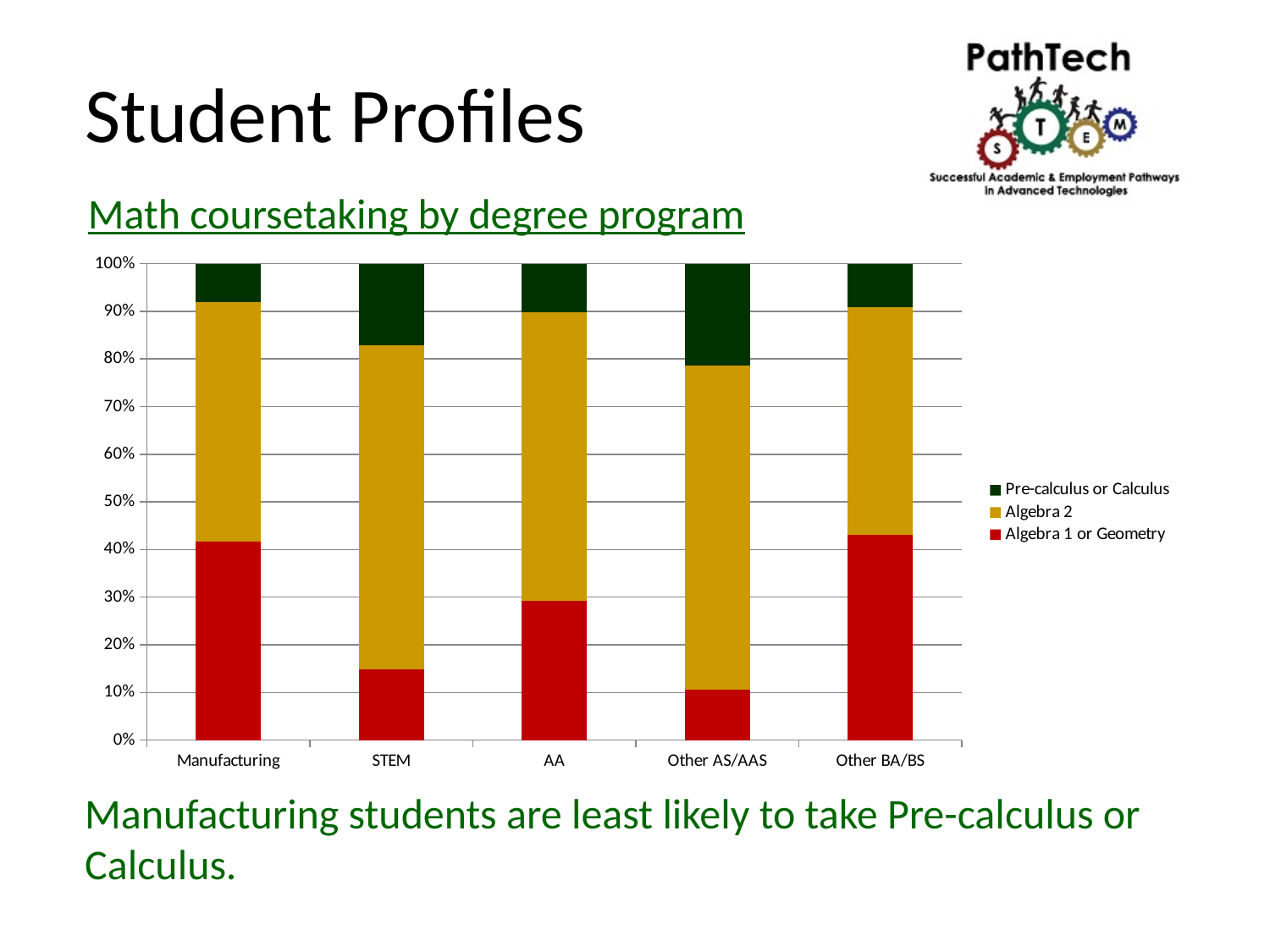
Is the Algebra 1 or Geometry share for STEM greater or less than 20%? less What is the title of the chart? Math coursetaking by degree program How many series does the legend list? 3 Is the Algebra 1 or Geometry share for Manufacturing greater or less than 40%? greater Which degree program has the smallest Algebra 1 or Geometry share? Other AS/AAS How many degree programs are shown along the x axis? 5 Which has the larger Algebra 1 or Geometry share, STEM or AA? AA What kind of chart is shown on the slide? Stacked bar chart What does each stacked bar total? 100% Which series is shown in red? Algebra 1 or Geometry Which degree program has the largest Pre-calculus or Calculus share? Other AS/AAS Is the Algebra 1 or Geometry share for Other AS/AAS greater or less than 20%? less